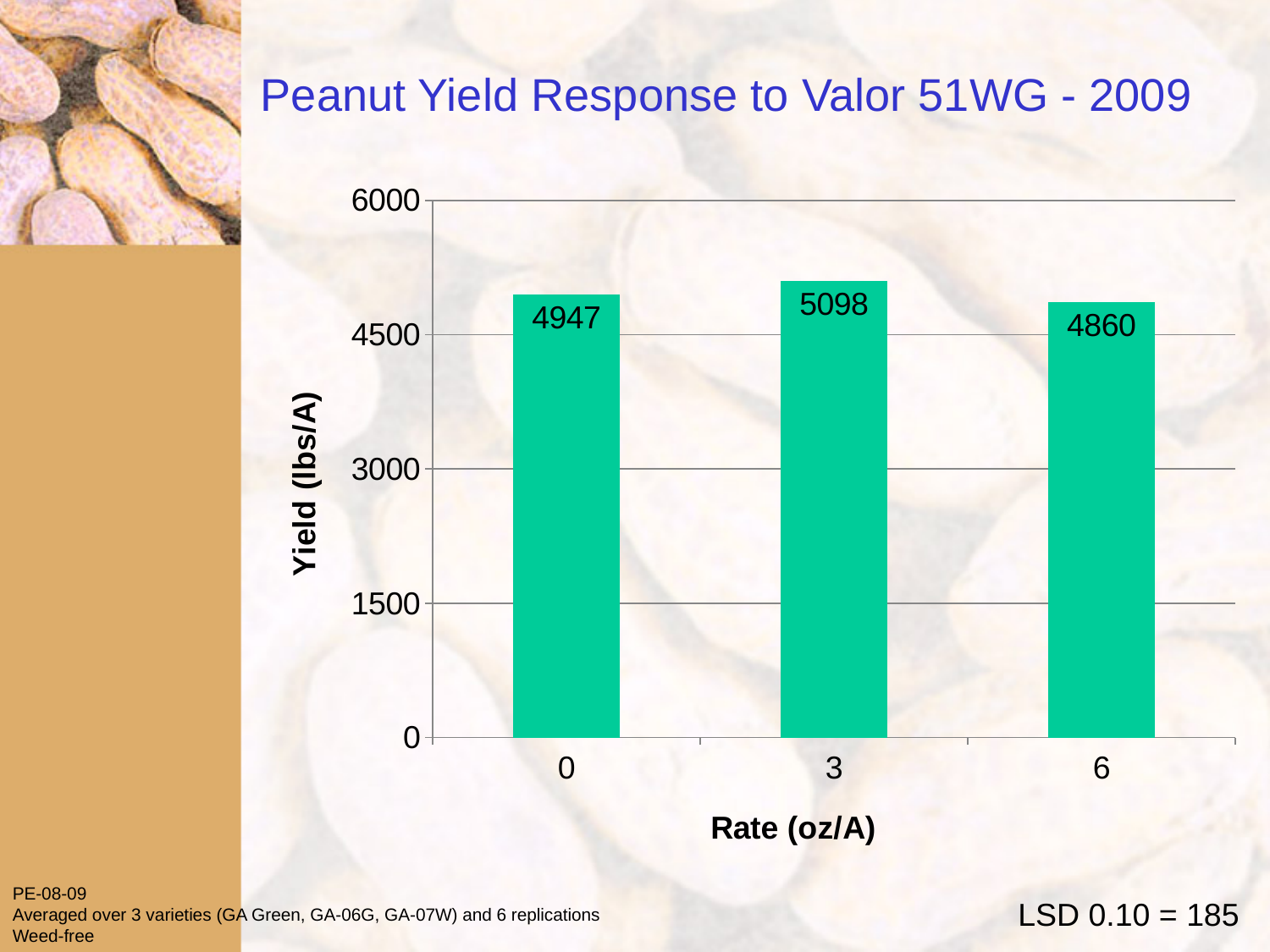
What is the yield at a rate of 0 oz/A? 4947 What is the difference in yield between the 3 oz/A rate and the 6 oz/A rate? 238 Is the yield at 3 oz/A greater or less than 4500? greater Which rate gives the highest yield? 3 Which has the larger yield, the 0 oz/A rate or the 6 oz/A rate? 0 oz/A How many rate categories are shown on the chart? 3 What is the yield at a rate of 6 oz/A? 4860 What is the label of the y axis? Yield (lbs/A) What is the difference in yield between the 3 oz/A rate and the 0 oz/A rate? 151 What kind of chart is shown on the slide? bar chart What is the yield at a rate of 3 oz/A? 5098 Which rate gives the lowest yield? 6